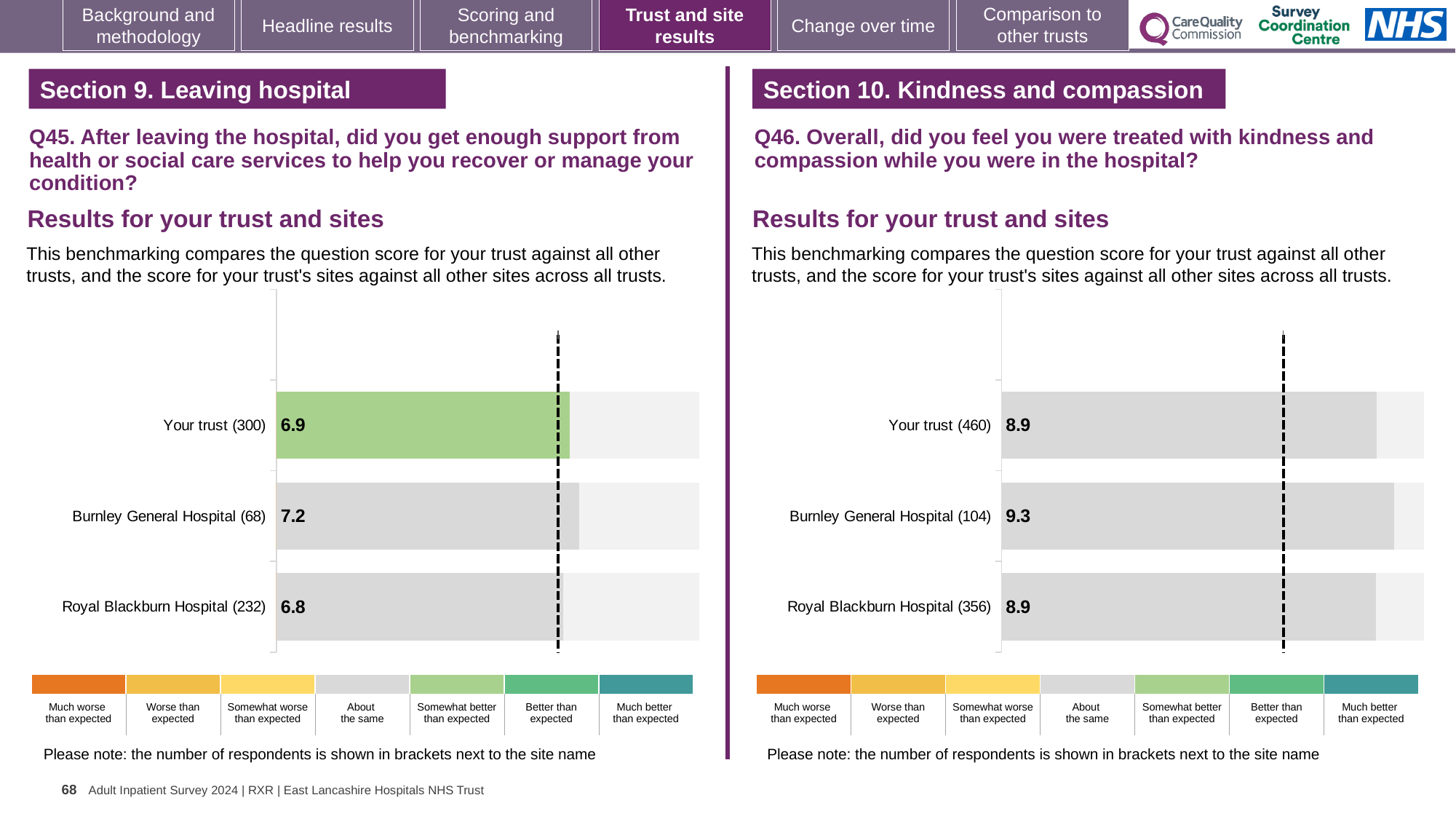
In the Q45 chart on the left, what is the score for Burnley General Hospital? 7.2 In the Q46 chart on the right, how many bars are plotted? 3 In the Q46 chart on the right, what is the score for Burnley General Hospital? 9.3 In the Q45 chart on the left, what is the score for Your trust? 6.9 In the Q46 chart on the right, which site or trust has the highest score? Burnley General Hospital In the Q45 chart on the left, what is the score for Royal Blackburn Hospital? 6.8 In the Q45 chart on the left, which site or trust has the highest score? Burnley General Hospital In the Q46 chart on the right, what is the score for Royal Blackburn Hospital? 8.9 What kind of chart is used for the Q45 results on the left? Bar chart In the Q45 chart on the left, how many respondents are shown in brackets for Royal Blackburn Hospital? 232 In the Q46 chart on the right, what is the difference between the scores for Burnley General Hospital and Your trust? 0.4 In the Q45 chart on the left, what is the difference between the scores for Burnley General Hospital and Royal Blackburn Hospital? 0.4